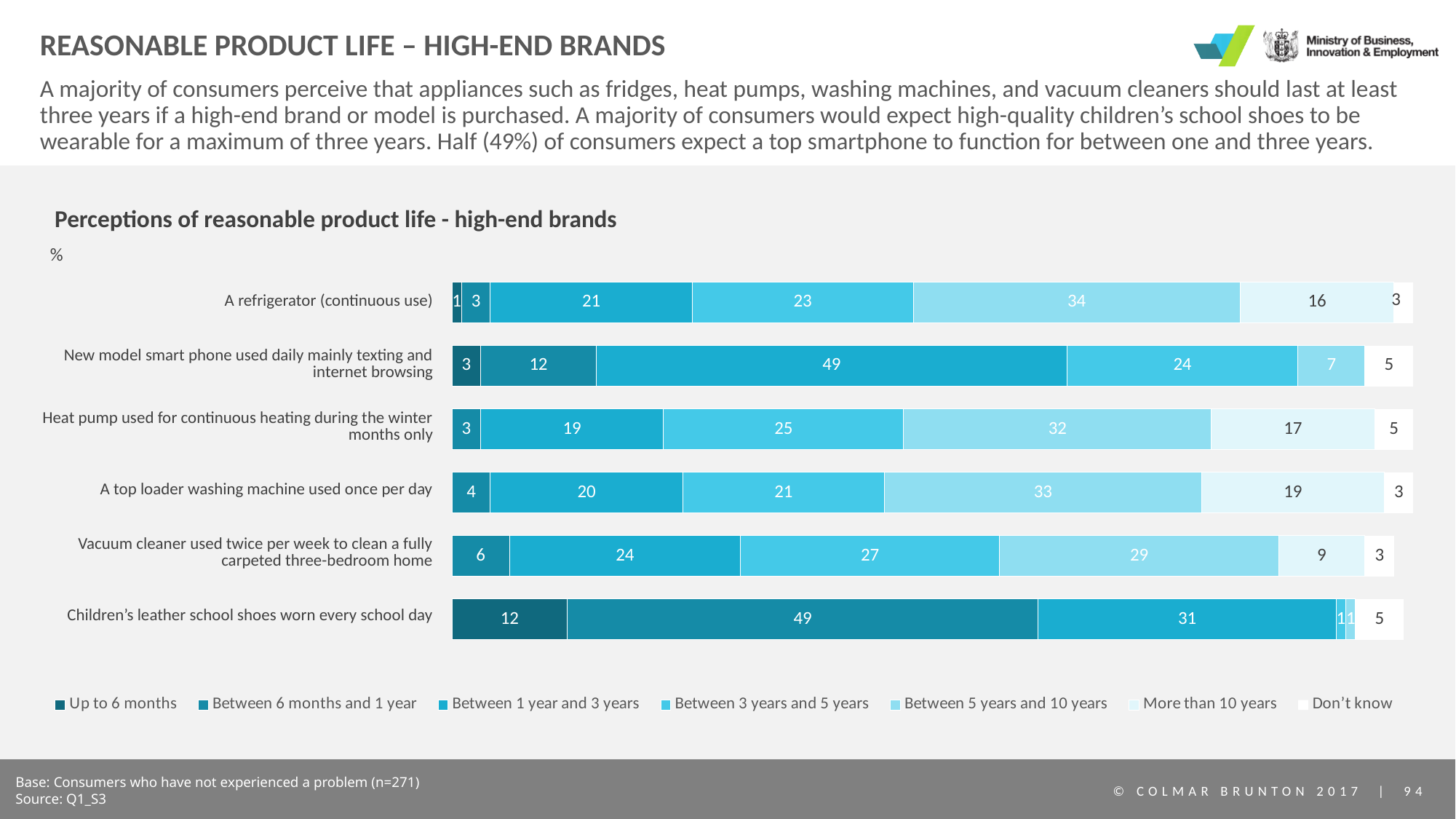
What is the largest segment value in the vacuum cleaner bar? 29 What type of chart is shown on the slide? Stacked bar chart What percentage of consumers expect a new model smart phone to last between 1 year and 3 years? 49 How many product categories are plotted in the chart? 6 Which has a larger largest segment: the smart phone bar (49) or the refrigerator bar (34)? Smart phone What is the 'Don't know' value for a refrigerator (continuous use)? 3 How many series does the legend list? 7 What is the largest segment value in the heat pump bar? 32 In the children's leather school shoes bar, what is the difference between the 49 segment and the 31 segment? 18 What is the title of the chart? Perceptions of reasonable product life - high-end brands What is the 'Up to 6 months' value for children's leather school shoes? 12 What is the 'Don't know' value for the heat pump used for continuous heating during the winter months only? 5